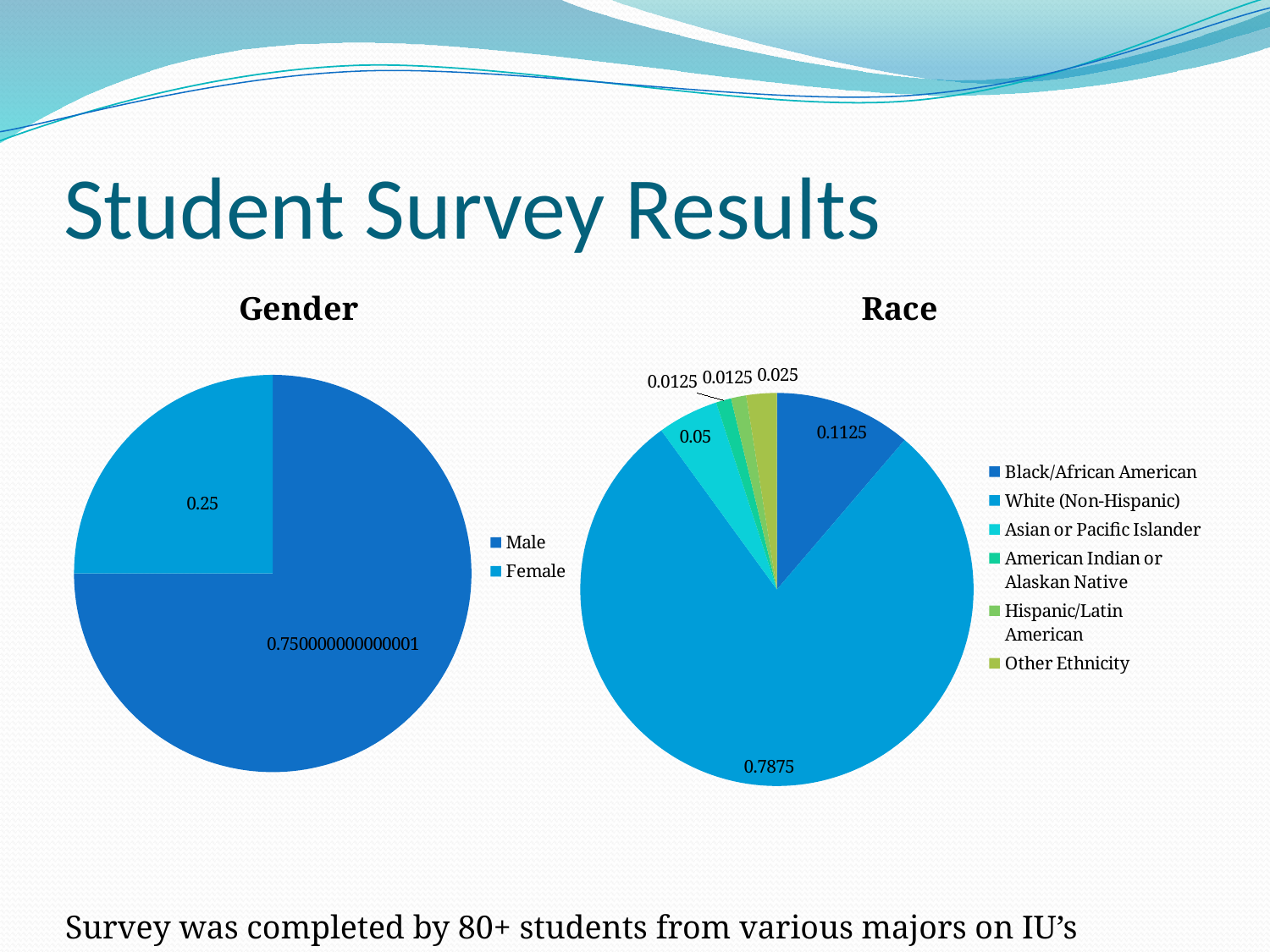
In the Race chart, what is the value for White (Non-Hispanic)? 0.7875 In the Gender chart, which category has the larger share, Male or Female? Male In the Race chart, which category has the largest share? White (Non-Hispanic) In the Race chart, what is the value for Other Ethnicity? 0.025 In the Gender chart, what is the value for Female? 0.25 In the Gender chart, what is the value shown for Male? 0.750000000000001 In the Race chart, what is the value for Asian or Pacific Islander? 0.05 What kind of chart is the Gender chart? pie chart In the Race chart, what is the difference between the values for White (Non-Hispanic) and Black/African American? 0.675 How many categories does the Race chart's legend list? 6 How many categories does the Gender chart's legend list? 2 In the Race chart, what is the value for Black/African American? 0.1125